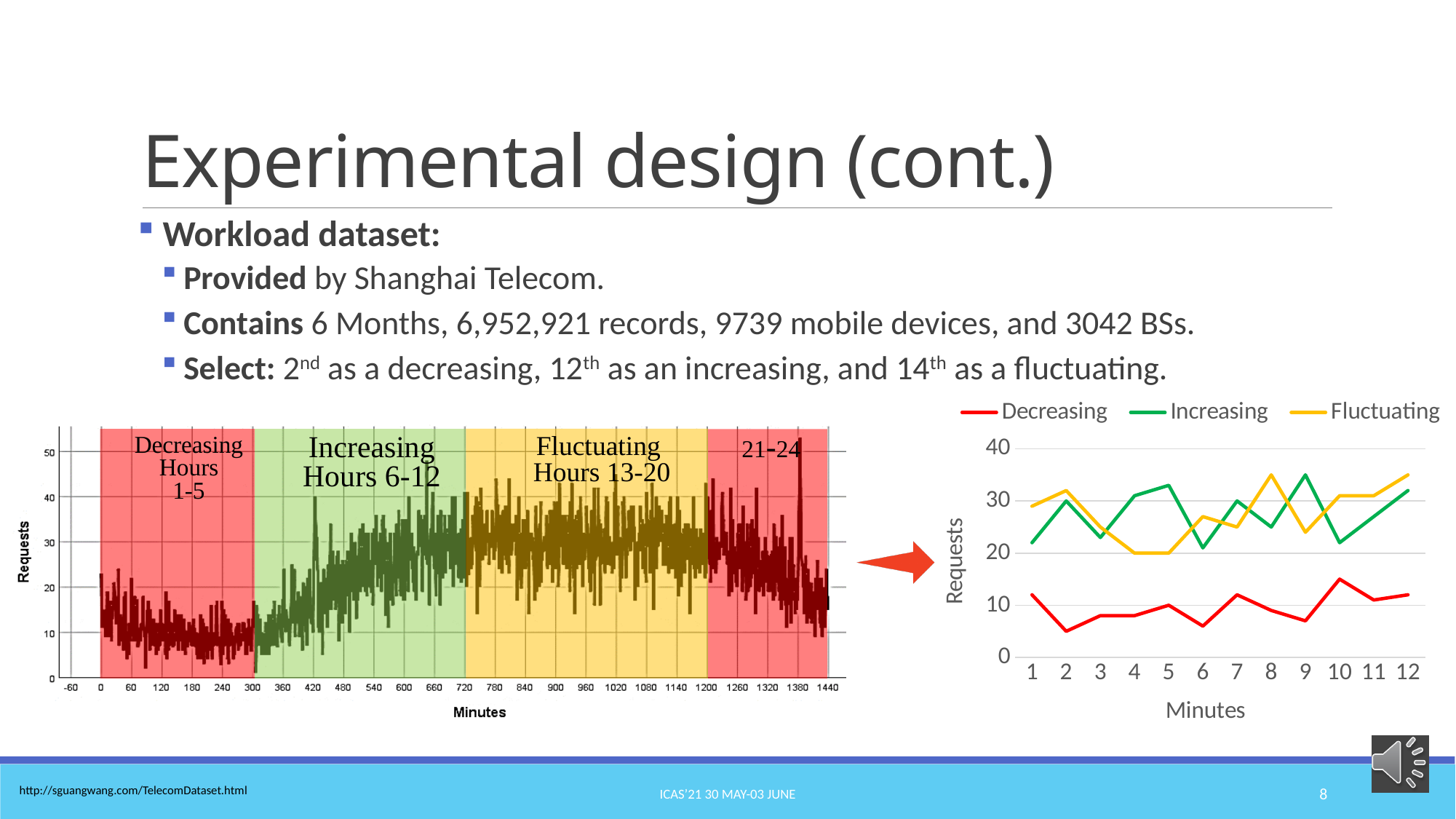
In the line chart on the right, what are the three series named in the legend? Decreasing, Increasing, Fluctuating In the line chart on the right, is the Decreasing value at minute 2 greater or less than 10? less In the line chart on the right, how many series does the legend list? 3 What kind of chart is the chart on the right of the slide? line chart In the line chart on the right, is the Decreasing value at minute 10 greater or less than 10? greater In the line chart on the right, at minute 9, which series has the larger value: Increasing or Fluctuating? Increasing In the line chart on the right, which series has the lowest values across all minutes? Decreasing In the chart on the left, what label is shown on the x axis? Minutes In the line chart on the right, how many points are plotted along the Minutes axis for each series? 12 In the line chart on the right, at minute 6, which series has the larger value: Fluctuating or Increasing? Fluctuating In the line chart on the right, is the Increasing value at minute 5 greater or less than 30? greater